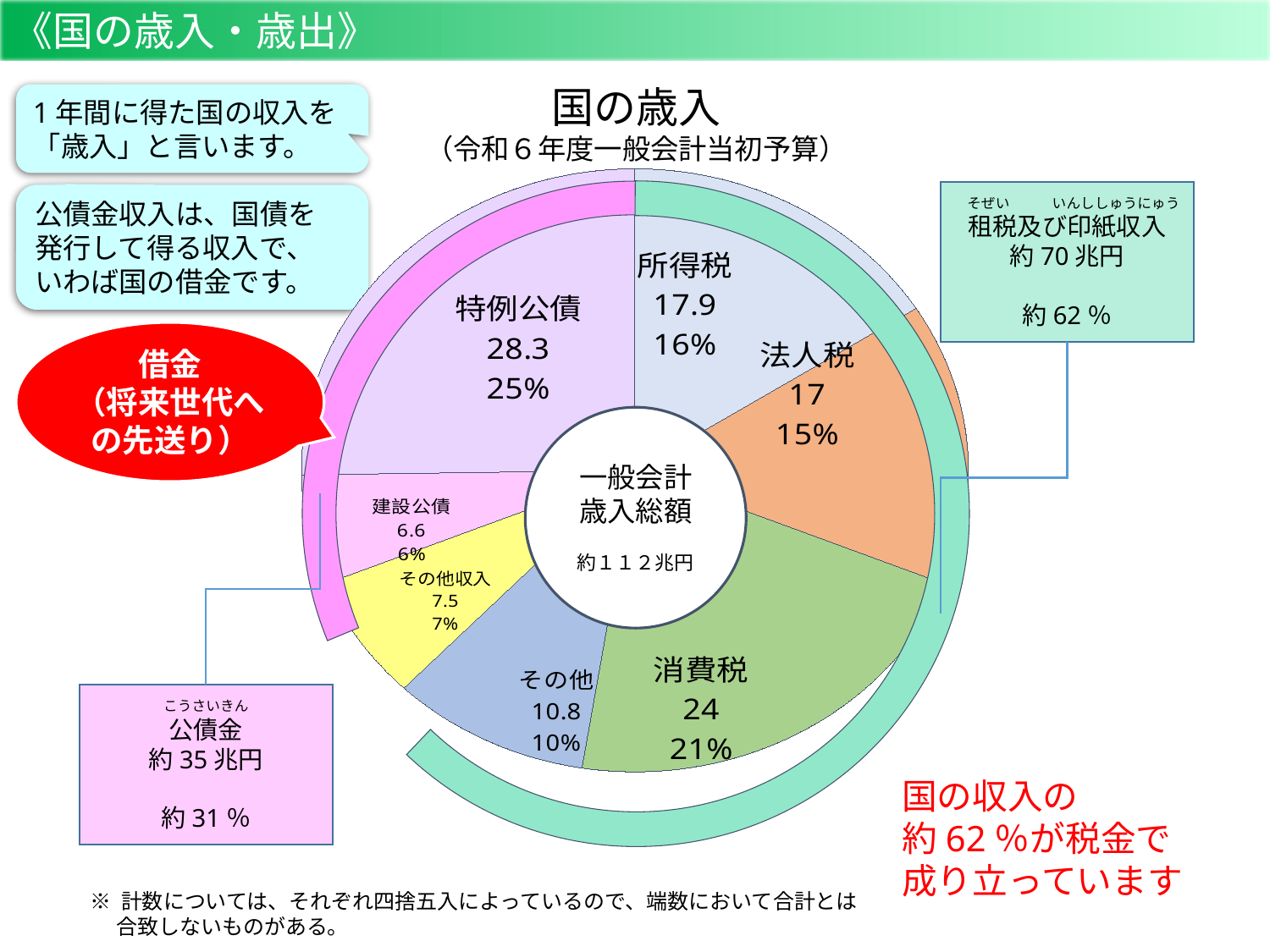
How many categories (slices) does the chart show? 7 Which category has the smallest value in the chart? 建設公債 What total is printed in the centre of the chart for 一般会計歳入総額? 約１１２兆円 What fiscal year budget does the chart subtitle say the data is from? 令和６年度一般会計当初予算 Which is larger, the value for 法人税 or the value for その他? 法人税 What kind of chart is used to show 国の歳入? Pie chart Which category has the largest value in the chart? 特例公債 What percentage share is shown for 消費税? 21% What is the difference between the values for 特例公債 and 消費税? 4.3 What is the value shown for 所得税 in the 国の歳入 chart? 17.9 What percentage share is shown for 特例公債? 25% What is the value shown for その他収入? 7.5